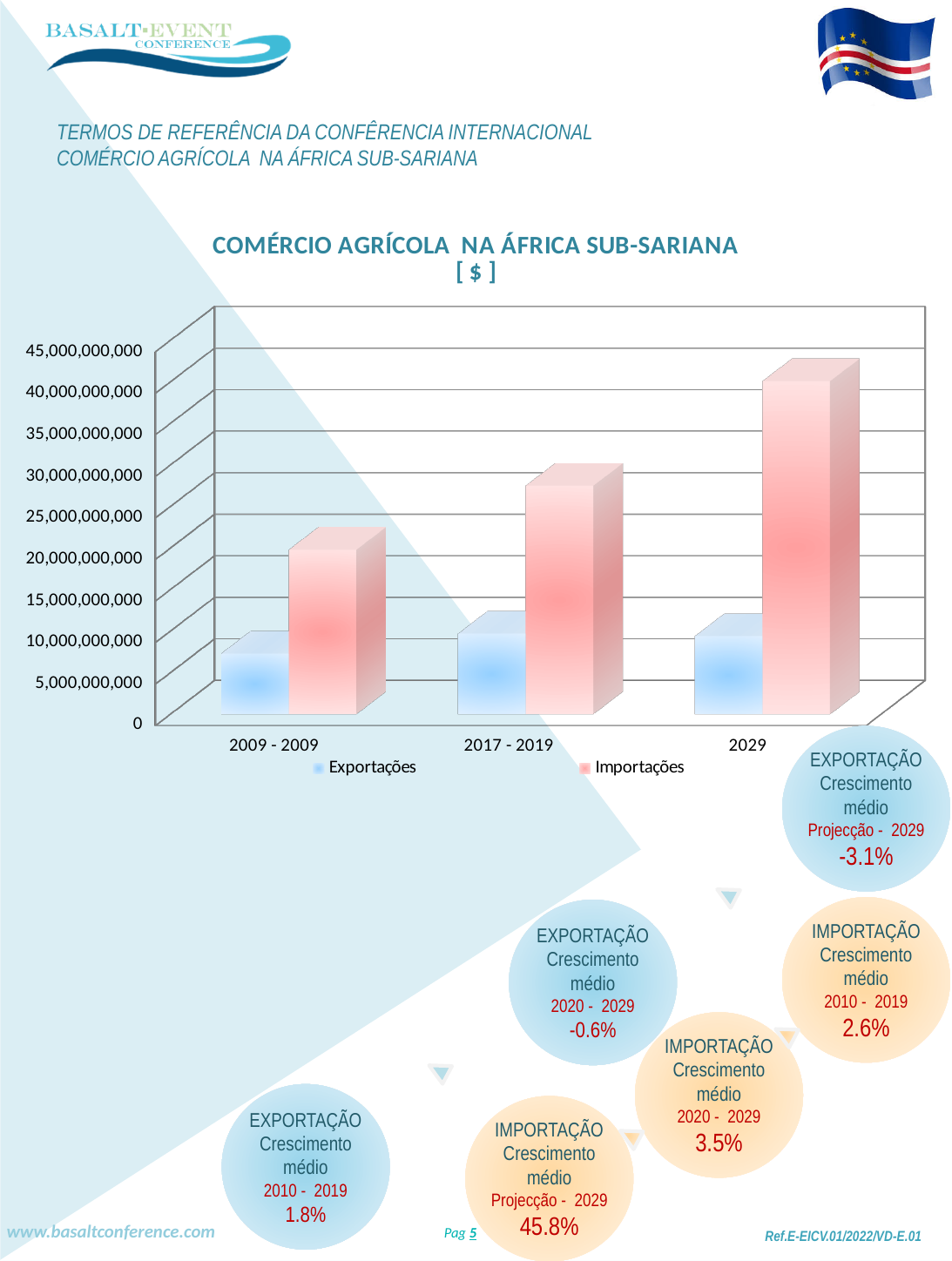
Do the values for Importações rise or fall from 2009 - 2009 to 2029? rise In which category is the value for Importações highest? 2029 How many series does the chart legend list? 2 Is the value for Importações in 2009 - 2009 greater or less than 25,000,000,000? less What kind of chart is shown on the slide? bar chart Is the value for Importações in 2017 - 2019 greater or less than 20,000,000,000? greater How many categories are shown on the x axis of the chart? 3 What is the title of the chart? COMÉRCIO AGRÍCOLA NA ÁFRICA SUB-SARIANA [ $ ] In which category is the value for Importações lowest? 2009 - 2009 Is the value for Exportações in 2009 - 2009 greater or less than 15,000,000,000? less In 2029, which is larger, Exportações or Importações? Importações